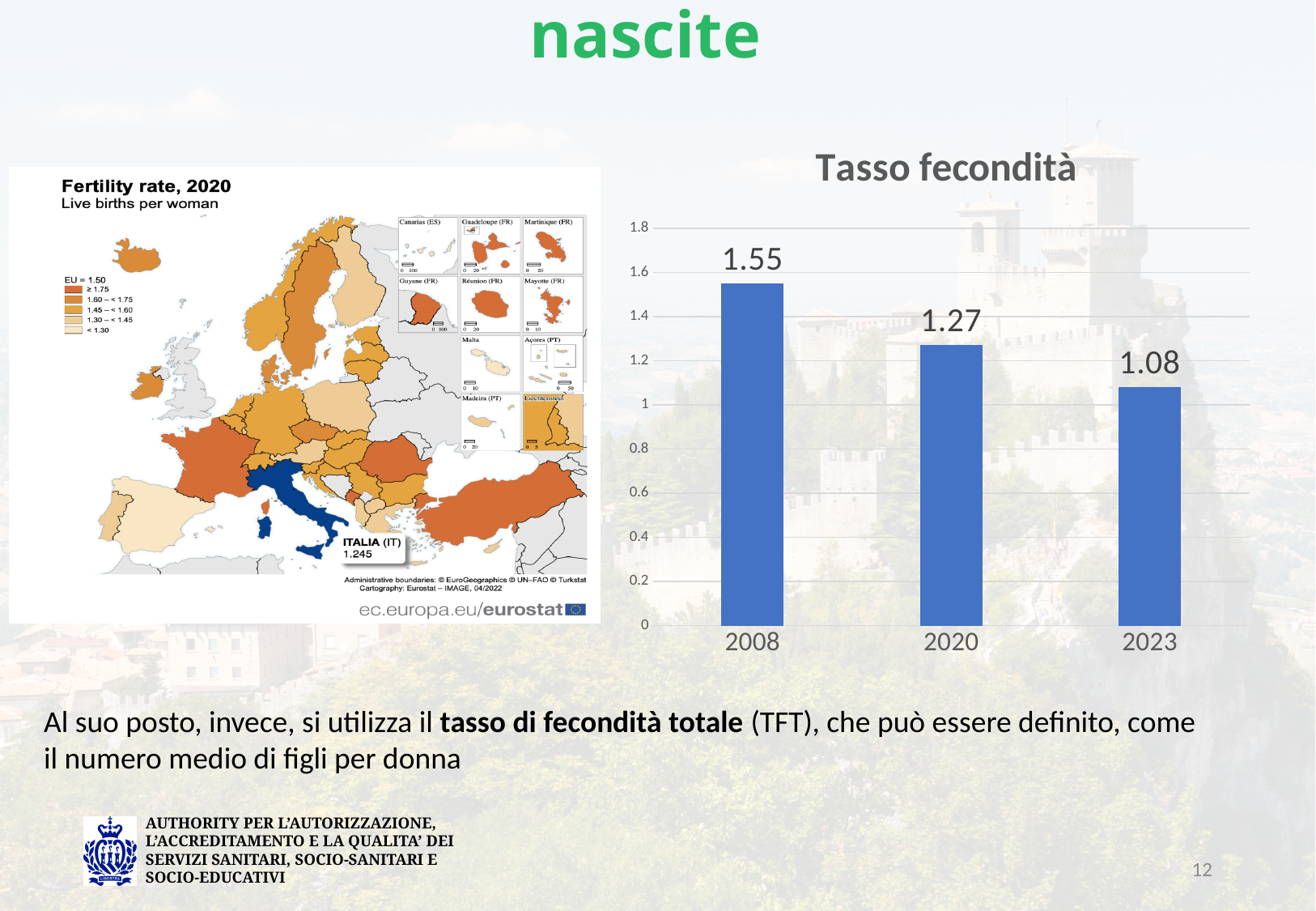
In the 'Tasso fecondità' chart, do the values rise or fall from 2008 to 2023? fall In the 'Tasso fecondità' chart, what is the difference between the 2008 and 2023 values? 0.47 In the 'Tasso fecondità' chart, what is the value for 2008? 1.55 In the 'Tasso fecondità' chart, what is the value for 2023? 1.08 In the 'Tasso fecondità' chart, what is the difference between the 2020 and 2023 values? 0.19 In the 'Tasso fecondità' chart, which year has the highest value? 2008 How many bars are shown in the 'Tasso fecondità' chart? 3 In the 'Tasso fecondità' chart, which is larger, the value for 2008 or the value for 2020? 2008 In the 'Tasso fecondità' chart, is the value for 2023 greater or less than 1.2? less In the 'Tasso fecondità' chart, what is the value for 2020? 1.27 What kind of chart is the 'Tasso fecondità' chart? bar chart In the 'Tasso fecondità' chart, which year has the lowest value? 2023